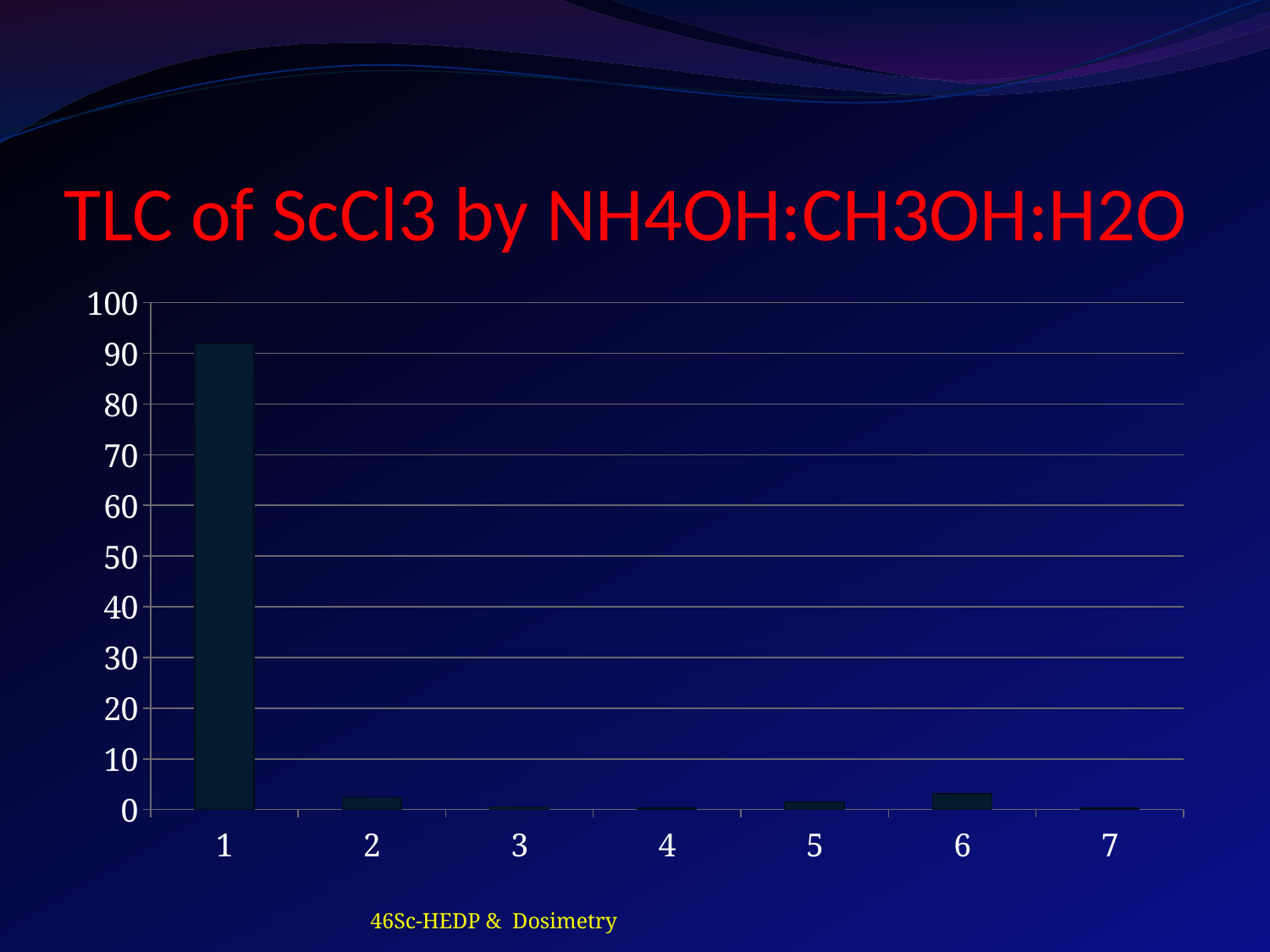
Which is larger, the value for category 6 or the value for category 3? category 6 What is the highest value shown on the y axis of the chart? 100 Is the value for category 6 greater or less than 10? less What is the title of the chart on the slide? TLC of ScCl3 by NH4OH:CH3OH:H2O Is the value for category 1 greater or less than 80? greater Which is larger, the value for category 1 or the value for category 2? category 1 How many categories are shown on the x axis of the chart? 7 What kind of chart is shown on the slide? bar chart Is the value for category 2 greater or less than 10? less Which is larger, the value for category 1 or the value for category 6? category 1 Which category has the highest bar in the chart? 1